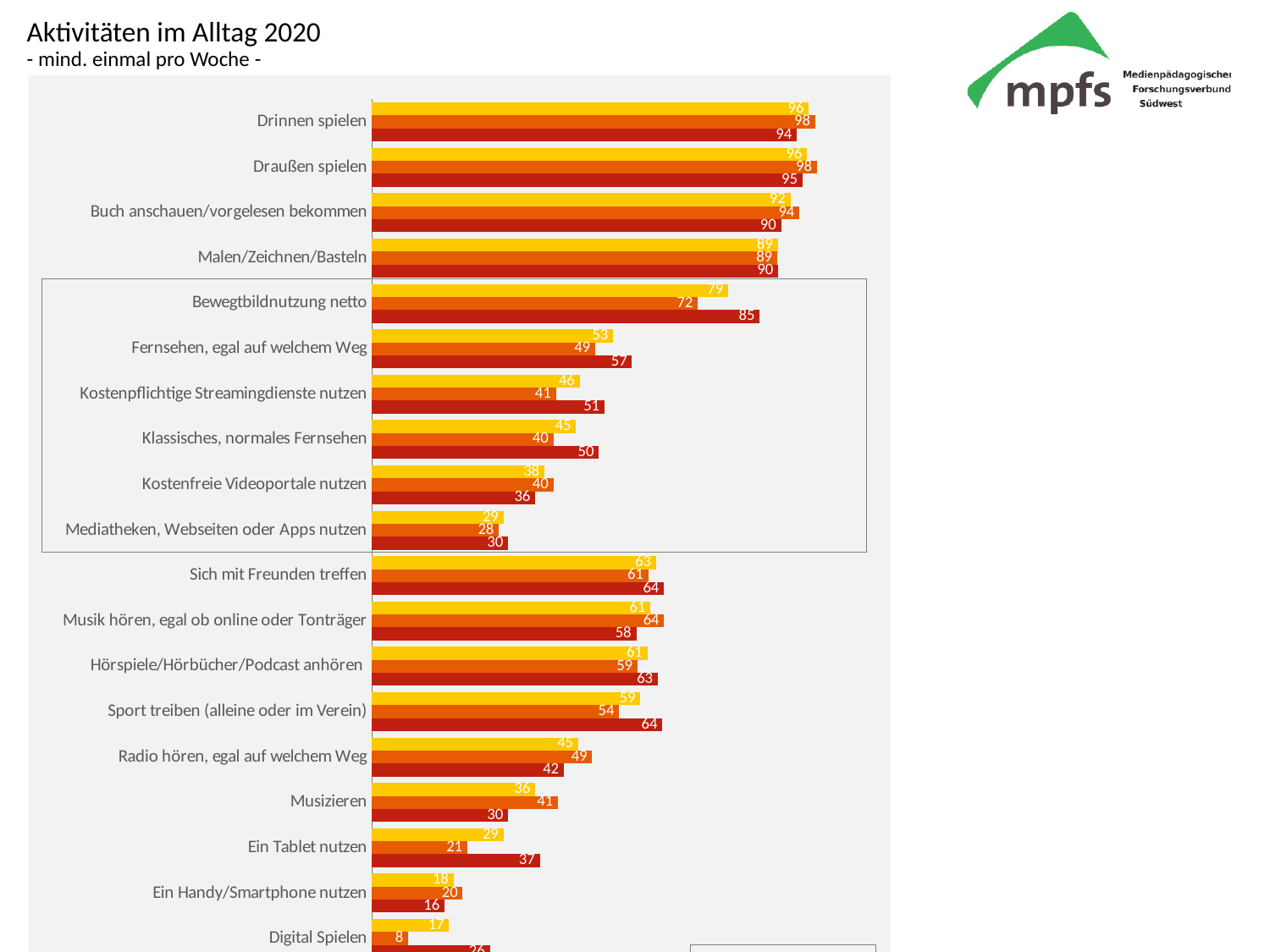
What is the value of the dark red (bottom) bar for "Ein Tablet nutzen"? 37 What is the value of the yellow (top) bar for "Kostenfreie Videoportale nutzen"? 38 Which is larger for "Musizieren": the orange (middle) bar or the dark red (bottom) bar? the orange (middle) bar What is the value of the orange (middle) bar for "Sport treiben (alleine oder im Verein)"? 54 What kind of chart is shown on the slide? bar chart What is the value of the yellow (top) bar for "Bewegtbildnutzung netto"? 79 What is the title of the slide? Aktivitäten im Alltag 2020 - mind. einmal pro Woche - Which is larger: the yellow (top) bar for "Fernsehen, egal auf welchem Weg" or the yellow (top) bar for "Klassisches, normales Fernsehen"? Fernsehen, egal auf welchem Weg What is the difference between the dark red (bottom) bar and the orange (middle) bar for "Bewegtbildnutzung netto"? 13 What is the difference between the yellow (top) bar and the orange (middle) bar for "Ein Tablet nutzen"? 8